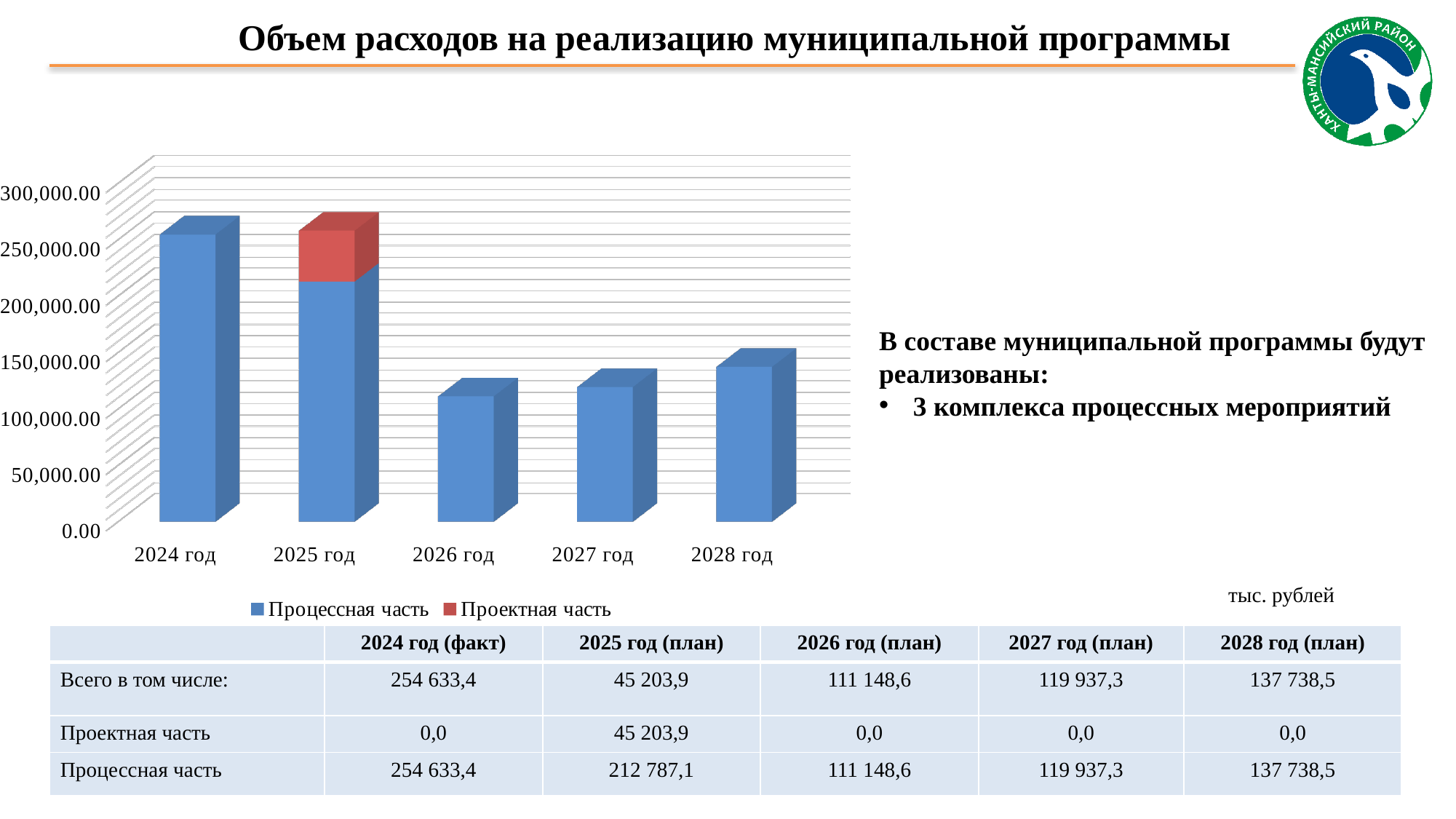
Which bar is taller in the chart, 2028 год or 2026 год? 2028 год Which year is the only one with a red (Проектная часть) segment in the chart? 2025 год According to the table on the slide, what is the Проектная часть value for 2025 год (план)? 45 203,9 How many year categories are shown on the x axis of the chart? 5 Is the value for 2024 год in the chart greater or less than 200,000.00? greater Do the bar values rise or fall from 2026 год to 2028 год? rise What are the two series named in the chart legend? Процессная часть, Проектная часть How many series does the chart legend list? 2 What kind of chart is shown on the slide? bar chart According to the table on the slide, what is the Процессная часть value for 2025 год (план)? 212 787,1 Is the value for 2028 год in the chart greater or less than 150,000.00? less Which year has the lowest bar in the chart? 2026 год